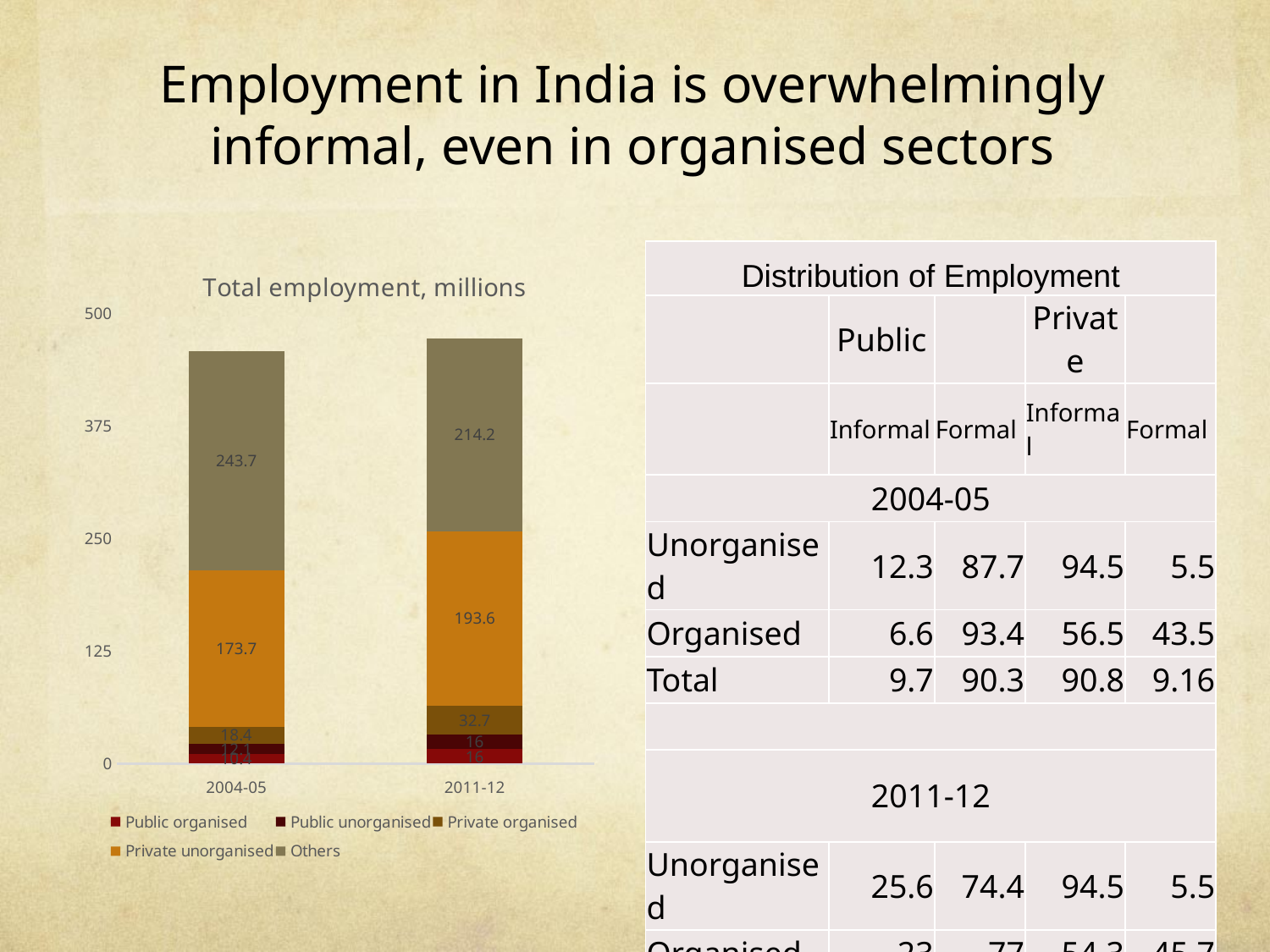
How many series does the legend of the 'Total employment, millions' chart list? 5 In the 'Total employment, millions' chart, what is the value for Private unorganised in 2011-12? 193.6 How many categories (years) are shown on the x axis of the 'Total employment, millions' chart? 2 In the 'Total employment, millions' chart, is the Others value larger in 2004-05 or in 2011-12? 2004-05 In the 'Total employment, millions' chart, what is the value for Others in 2011-12? 214.2 In the 'Total employment, millions' chart, what is the value for Private unorganised in 2004-05? 173.7 In the 'Total employment, millions' chart, is the total height of the 2011-12 bar greater or less than 375? greater In the 'Total employment, millions' chart, what is the value for Private organised in 2011-12? 32.7 What kind of chart is shown on the slide? Stacked bar chart In the 'Total employment, millions' chart, what is the difference between the Others value in 2004-05 and in 2011-12? 29.5 In the 'Total employment, millions' chart, what is the value for Others in 2004-05? 243.7 In the 'Total employment, millions' chart, does the Private unorganised value rise or fall from 2004-05 to 2011-12? Rise